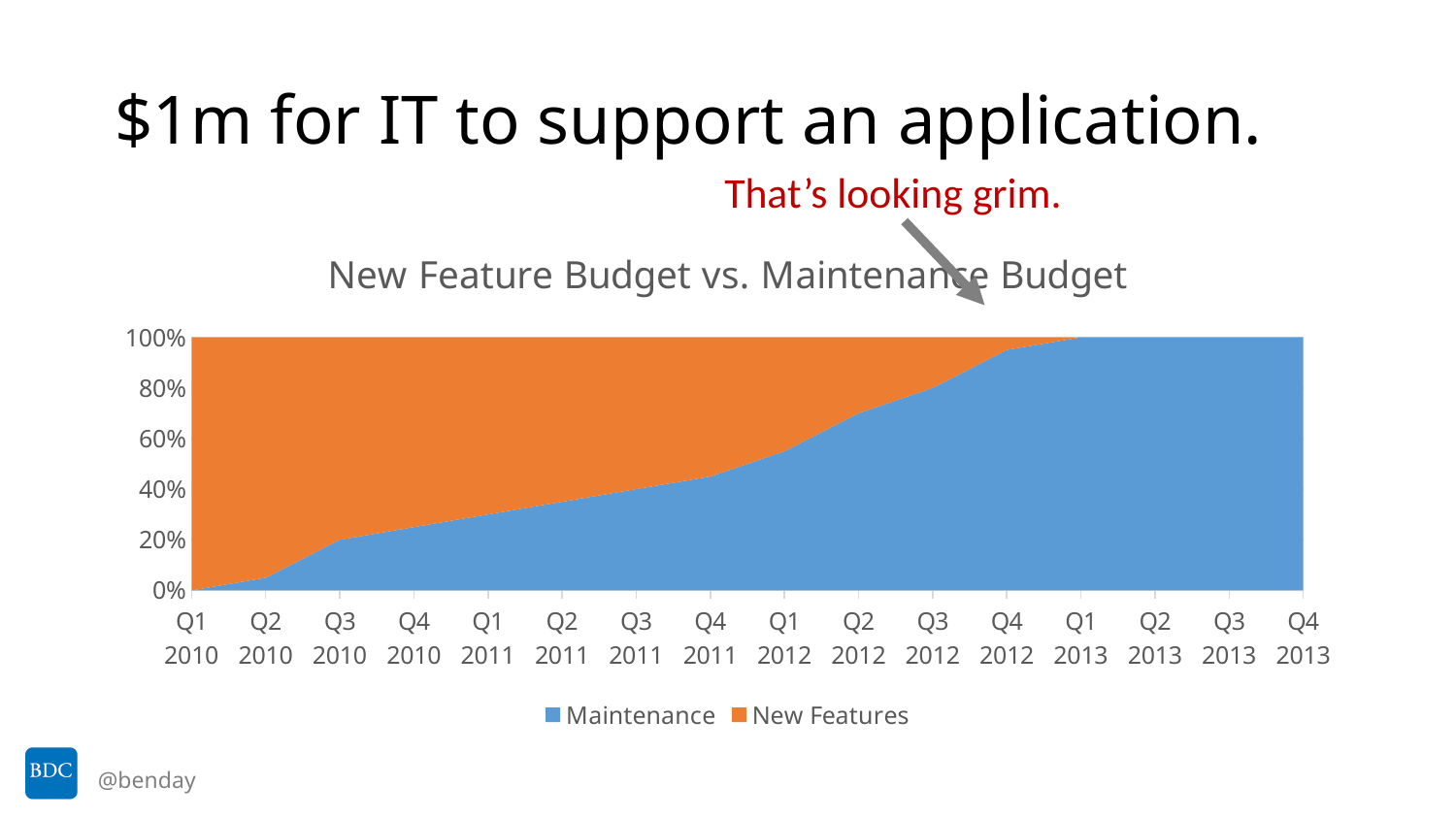
Is the Maintenance share in Q4 2012 greater or less than 80%? greater Which quarter has the lowest Maintenance share? Q1 2010 What kind of chart is shown on the slide? Area chart Does the Maintenance share rise or fall from Q1 2010 to Q4 2013? Rise In Q1 2010, which series has the larger share, Maintenance or New Features? New Features Is the Maintenance share in Q4 2011 greater or less than 60%? less What is the title of the chart? New Feature Budget vs. Maintenance Budget How many series does the legend list? 2 How many quarters are shown on the x axis? 16 Does the New Features share rise or fall from Q1 2010 to Q4 2013? Fall Is the Maintenance share in Q1 2010 greater or less than 20%? less Which series is shown in orange? New Features